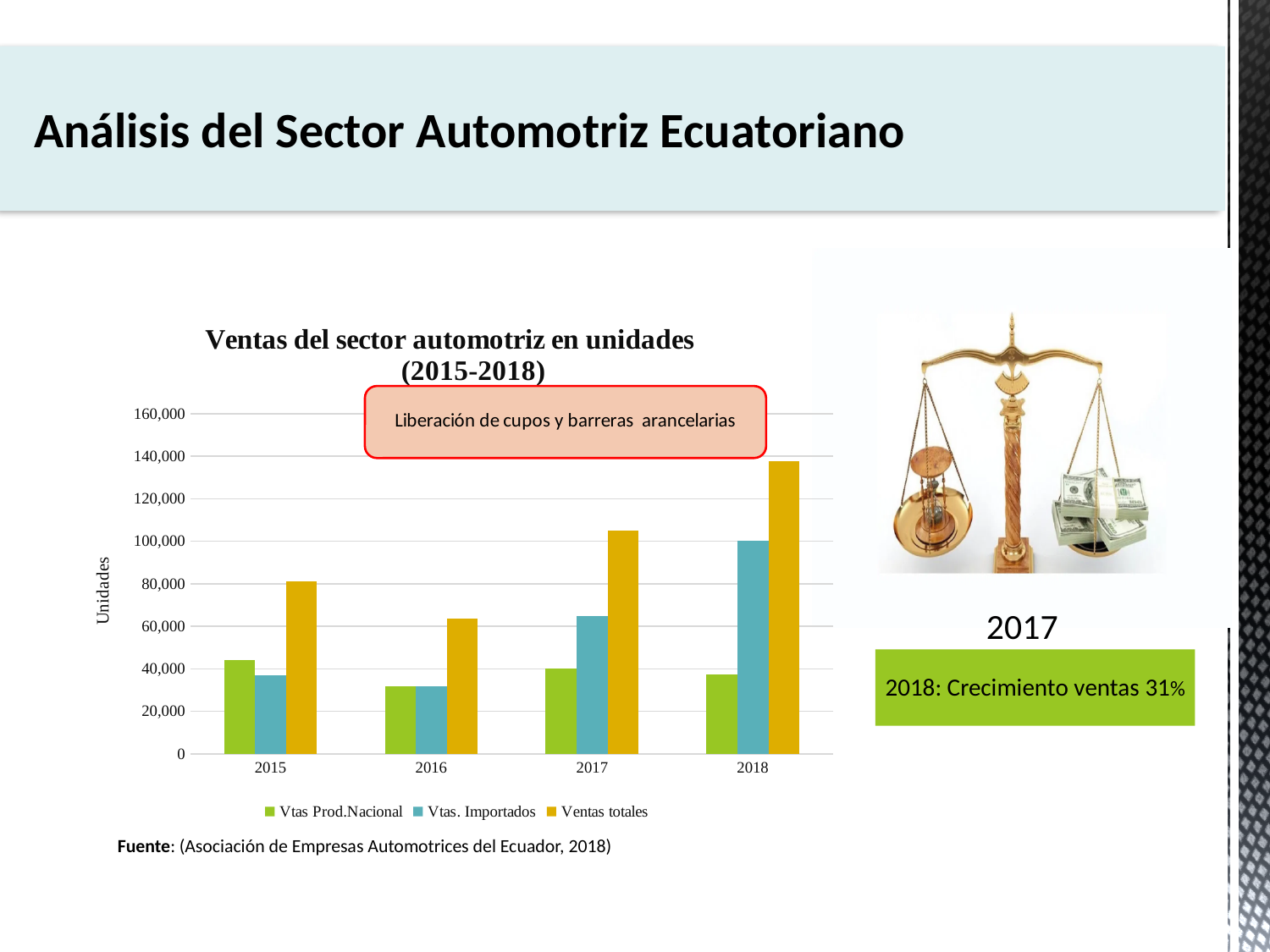
In which year is the Vtas Prod.Nacional bar the highest? 2015 In 2018, which is larger: Vtas Prod.Nacional or Vtas. Importados? Vtas. Importados How many years are shown on the x axis of the chart? 4 In which year is the Ventas totales bar the highest? 2018 In which year is the Ventas totales bar the lowest? 2016 Do the Vtas. Importados values rise or fall from 2016 to 2018? rise Is the Vtas. Importados value for 2017 greater or less than 60,000? greater What is the title of the chart? Ventas del sector automotriz en unidades (2015-2018) How many series does the legend of the chart list? 3 Is the Ventas totales value for 2018 greater or less than 120,000? greater What kind of chart is shown on the slide? bar chart Is the Ventas totales value for 2015 greater or less than 100,000? less